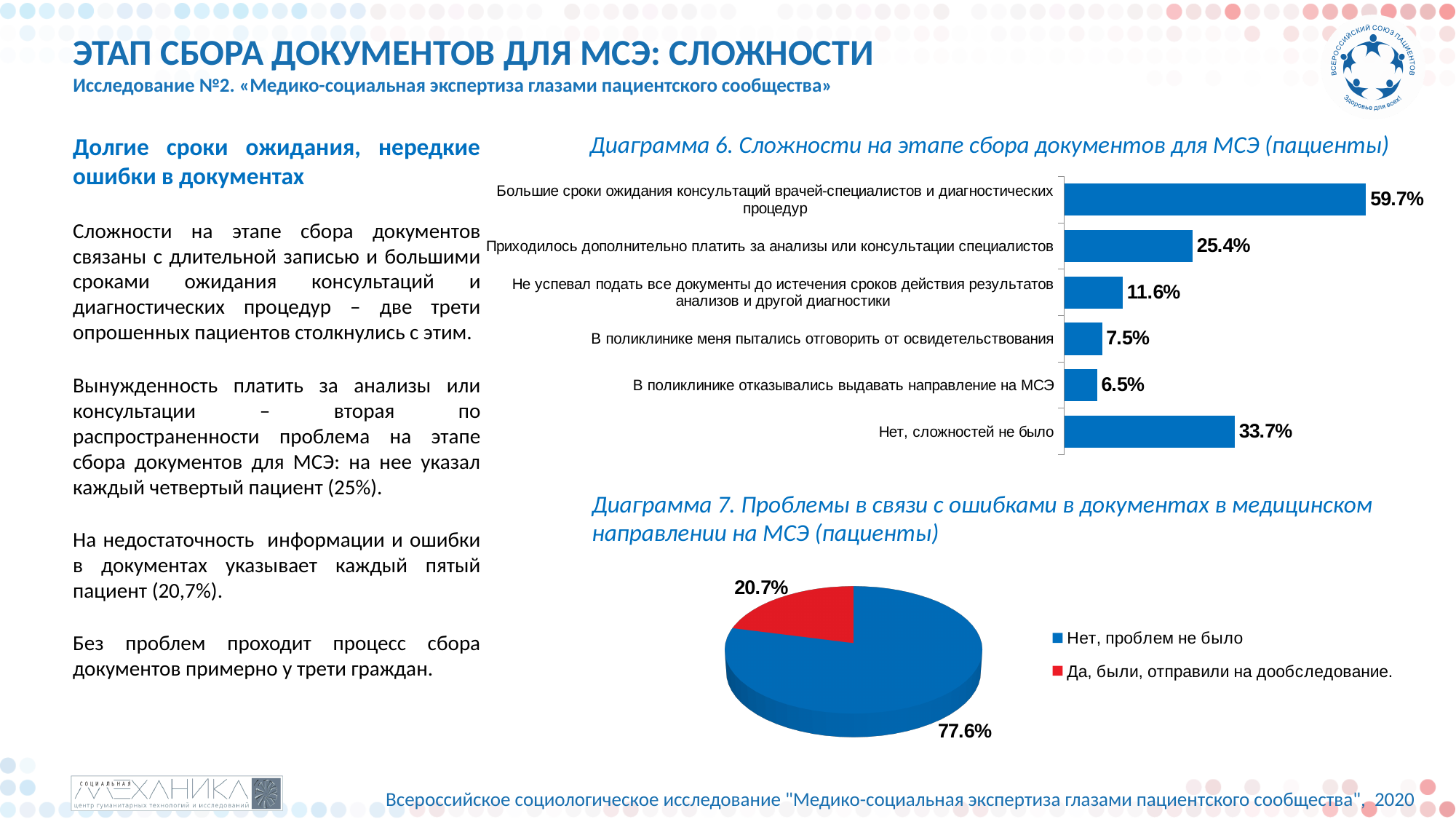
In Диаграмма 6, what is the value for «Большие сроки ожидания консультаций врачей-специалистов и диагностических процедур»? 59.7% How many entries does the legend of Диаграмма 7 list? 2 In Диаграмма 6, what is the value for «Нет, сложностей не было»? 33.7% What kind of chart is Диаграмма 7? Pie chart How many categories are shown in Диаграмма 6? 6 What kind of chart is Диаграмма 6? Bar chart In Диаграмма 6, what is the value for «В поликлинике отказывались выдавать направление на МСЭ»? 6.5% In Диаграмма 6, what is the difference between «Приходилось дополнительно платить за анализы или консультации специалистов» and «Не успевал подать все документы до истечения сроков действия результатов анализов и другой диагностики»? 13.8% In Диаграмма 6, which is larger: «В поликлинике меня пытались отговорить от освидетельствования» or «В поликлинике отказывались выдавать направление на МСЭ»? В поликлинике меня пытались отговорить от освидетельствования In Диаграмма 6, which category has the lowest value? В поликлинике отказывались выдавать направление на МСЭ In Диаграмма 6, which category has the highest value? Большие сроки ожидания консультаций врачей-специалистов и диагностических процедур In Диаграмма 7, what share is «Да, были, отправили на дообследование.»? 20.7%